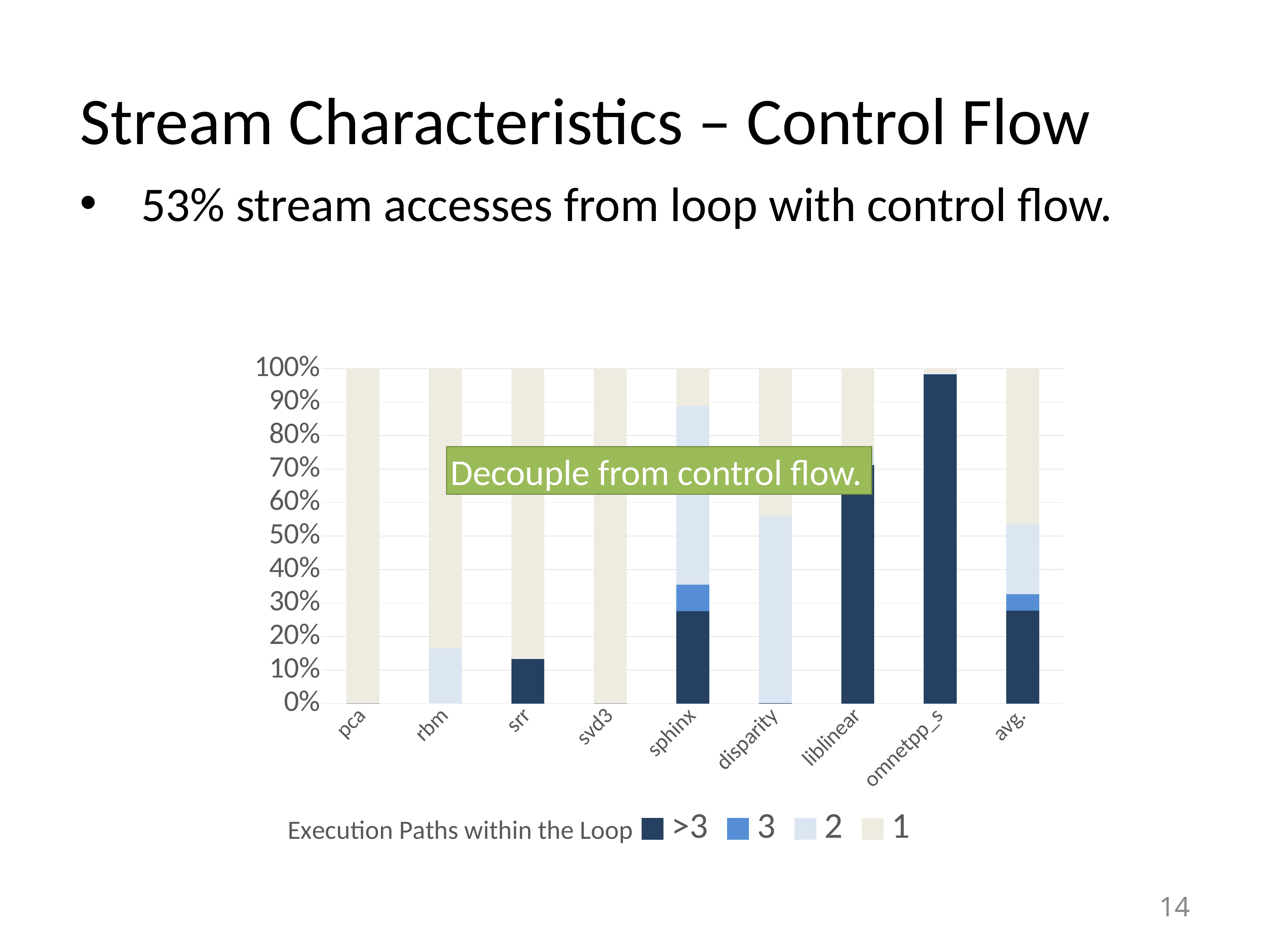
What text appears in the green box overlaid on the chart? Decouple from control flow. Is the '>3' segment for omnetpp_s greater or less than 90%? greater What is the total height of the stacked bar for pca? 100% Is the '2' segment for disparity greater or less than 50%? greater Which category has the largest '>3' segment? omnetpp_s Is the '>3' segment for srr greater or less than 20%? less How many categories are shown along the x axis of the chart? 9 What kind of chart is shown on the slide? stacked bar chart How many series does the chart's legend list? 4 Which has a larger '>3' segment, liblinear or srr? liblinear What is the title of the legend in the chart? Execution Paths within the Loop